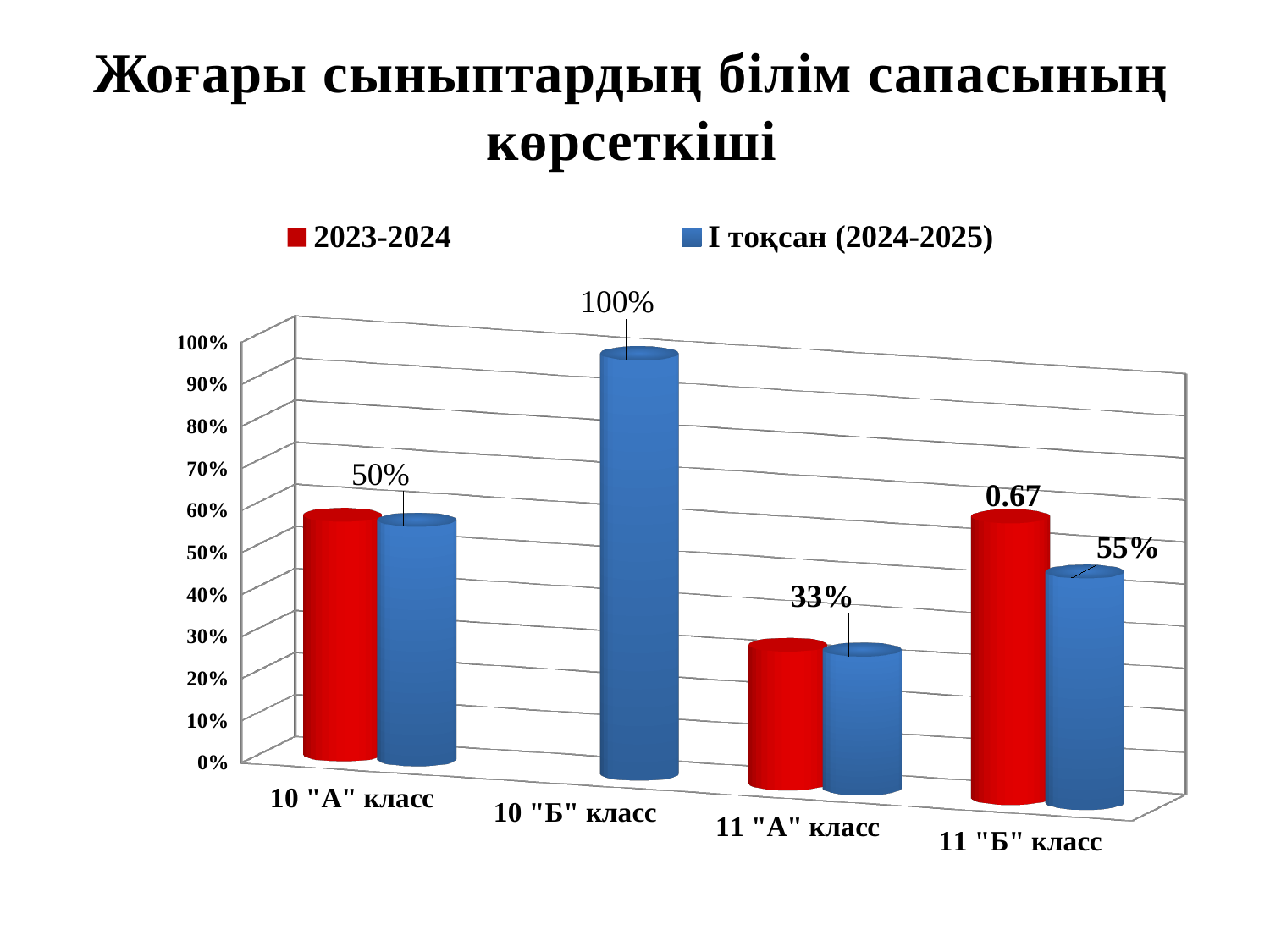
What is the 2023-2024 value for 11 "Б" класс? 0.67 What is the I тоқсан (2024-2025) value for 10 "А" класс? 50% What is the I тоқсан (2024-2025) value for 10 "Б" класс? 100% Which class has the highest I тоқсан (2024-2025) value? 10 "Б" класс Which class has the lowest I тоқсан (2024-2025) value? 11 "А" класс What is the I тоқсан (2024-2025) value for 11 "А" класс? 33% Which is larger, the I тоқсан (2024-2025) value for 11 "Б" класс or for 11 "А" класс? 11 "Б" класс What is the difference between the I тоқсан (2024-2025) values for 10 "Б" класс and 11 "А" класс? 67% Is the 2023-2024 value for 11 "А" класс greater or less than 50%? less What is the I тоқсан (2024-2025) value for 11 "Б" класс? 55% How many classes are shown on the x axis? 4 How many series does the legend list? 2